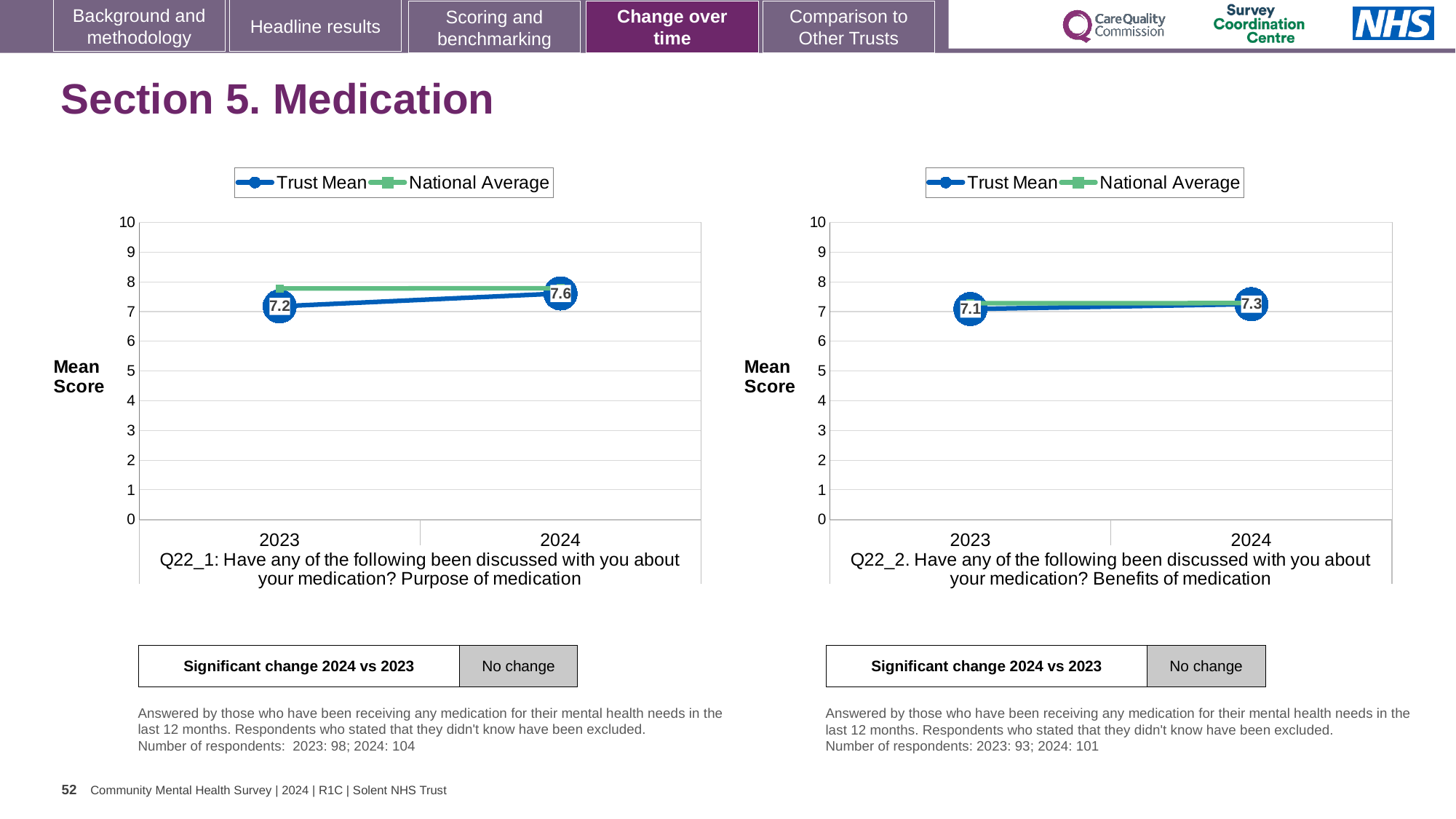
In the Q22_1 chart (left), does the Trust Mean rise or fall from 2023 to 2024? rise In the Q22_1 chart (left), in 2023, which is higher: the Trust Mean or the National Average? National Average In the Q22_2 chart (right), what is the difference between the Trust Mean in 2024 and in 2023? 0.2 How many series does the legend of the Q22_2 chart (right) list? 2 In the Q22_2 chart (right), what is the Trust Mean for 2024? 7.3 In the Q22_1 chart (left), what is the Trust Mean for 2024? 7.6 In the Q22_1 chart (left), by how much did the Trust Mean change from 2023 to 2024? 0.4 In the Q22_1 chart (left), what is the Trust Mean for 2023? 7.2 In the Q22_2 chart (right), what is the Trust Mean for 2023? 7.1 In the Q22_1 chart (left), which year has the higher Trust Mean? 2024 In the Q22_1 chart (left), is the National Average for 2023 greater or less than 7? greater What type of chart is the Q22_2 chart (right)? line chart